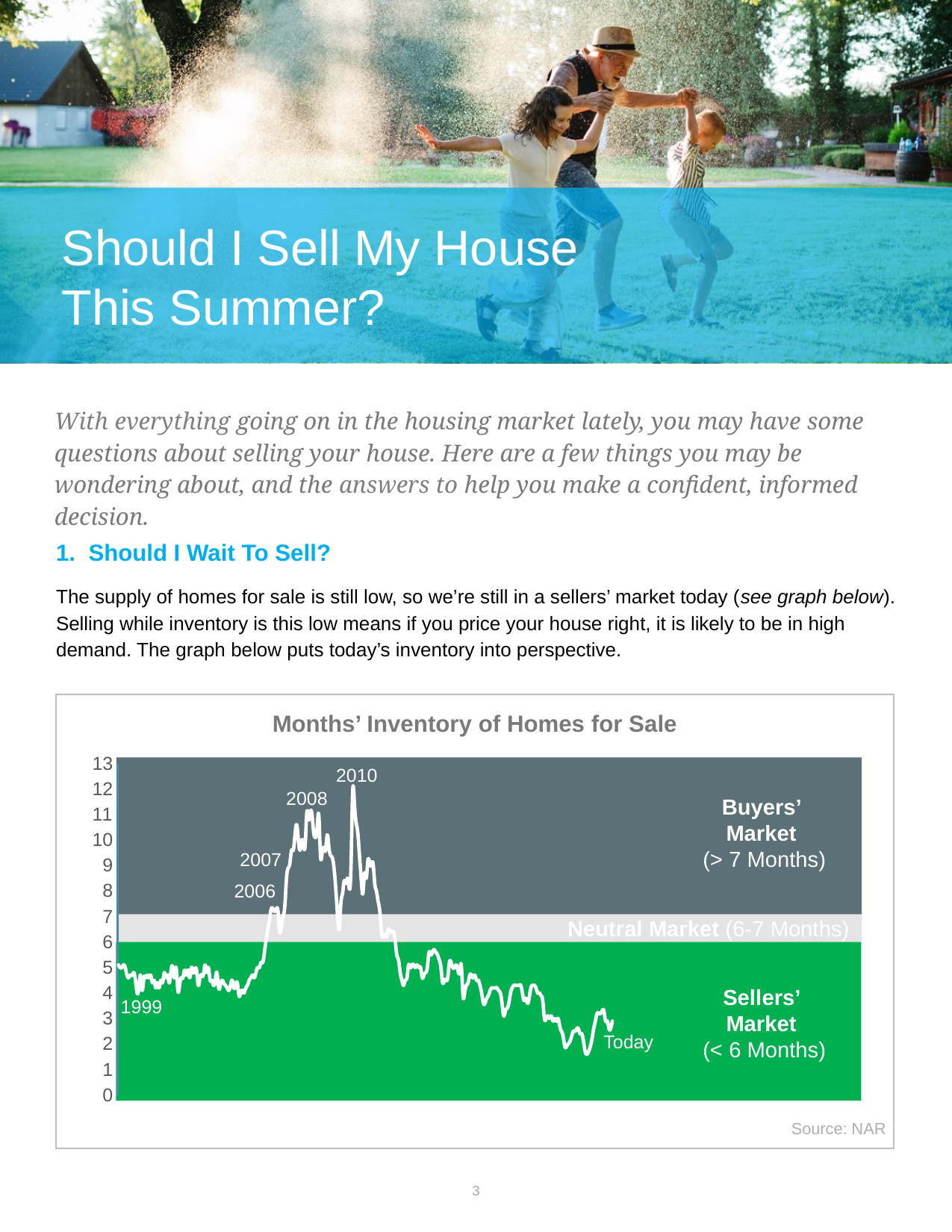
Which market band does the line fall in at the point labeled Today? Sellers' Market Which is higher, the value at the 2010 peak or the value in 1999? 2010 Is the value in 1999 greater or less than 6? less What is the source cited for the chart? NAR Which is higher, the value in 1999 or the value labeled Today? 1999 Does the line rise or fall from the 2010 peak to Today? fall Is the value at the 2008 peak greater or less than 10? greater Is the value at the 2010 peak greater or less than 11? greater Which labeled year marks the highest point on the line? 2010 What kind of chart is shown on the slide? line chart What is the title of the chart? Months' Inventory of Homes for Sale